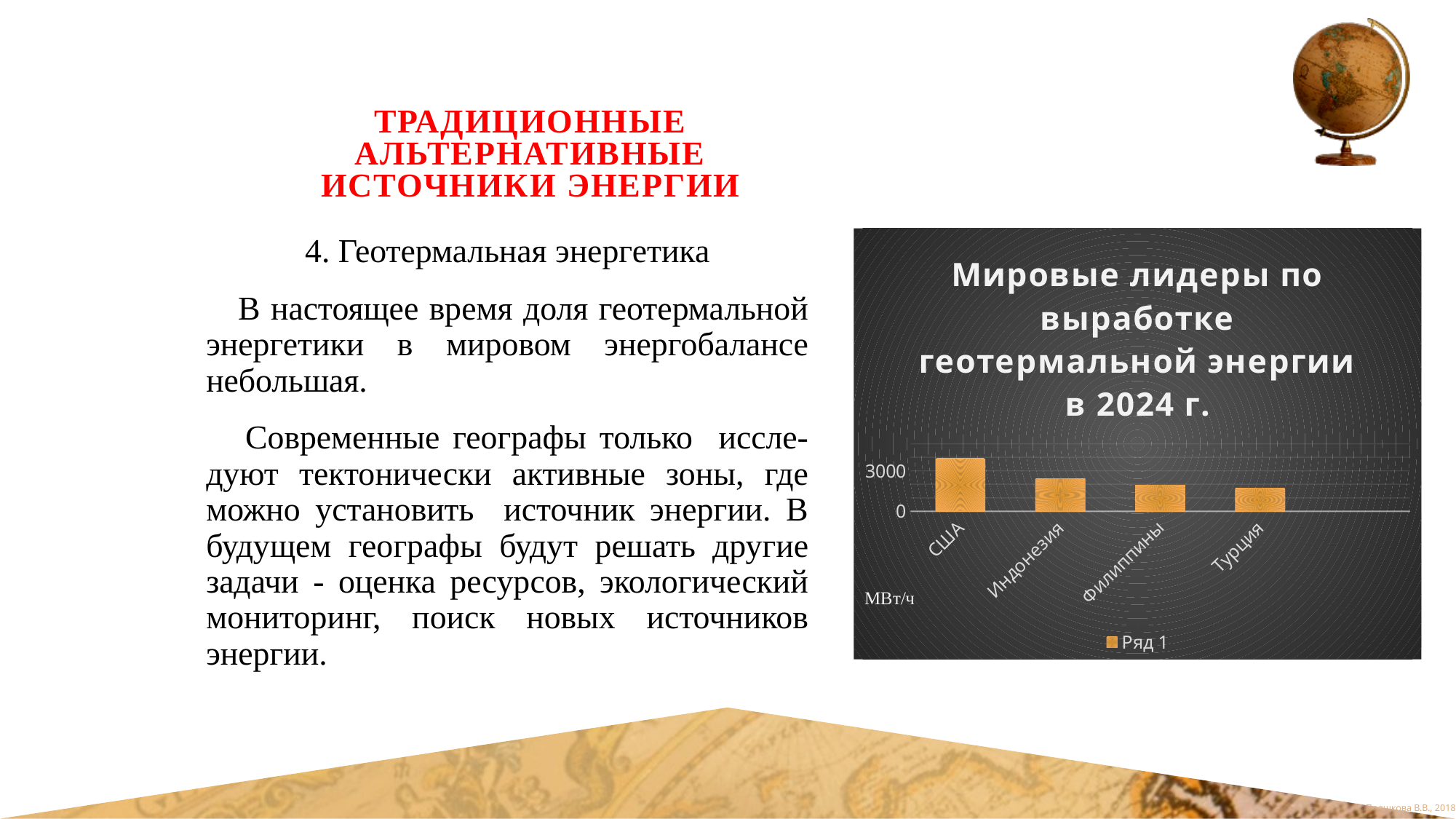
Is the value for США greater or less than 3000? greater Which is larger, the value for Индонезия or the value for Турция? Индонезия How many series does the legend list? 1 What kind of chart is shown on the slide? bar chart How many countries are shown on the chart? 4 Which country has the highest value on the chart? США What is the title of the chart? Мировые лидеры по выработке геотермальной энергии в 2024 г. Which is larger, the value for США or the value for Индонезия? США Do the values rise or fall from left to right along the x axis? fall Is the value for Турция greater or less than 3000? less What unit is shown on the chart's vertical axis? МВт/ч Is the value for Индонезия greater or less than 3000? less